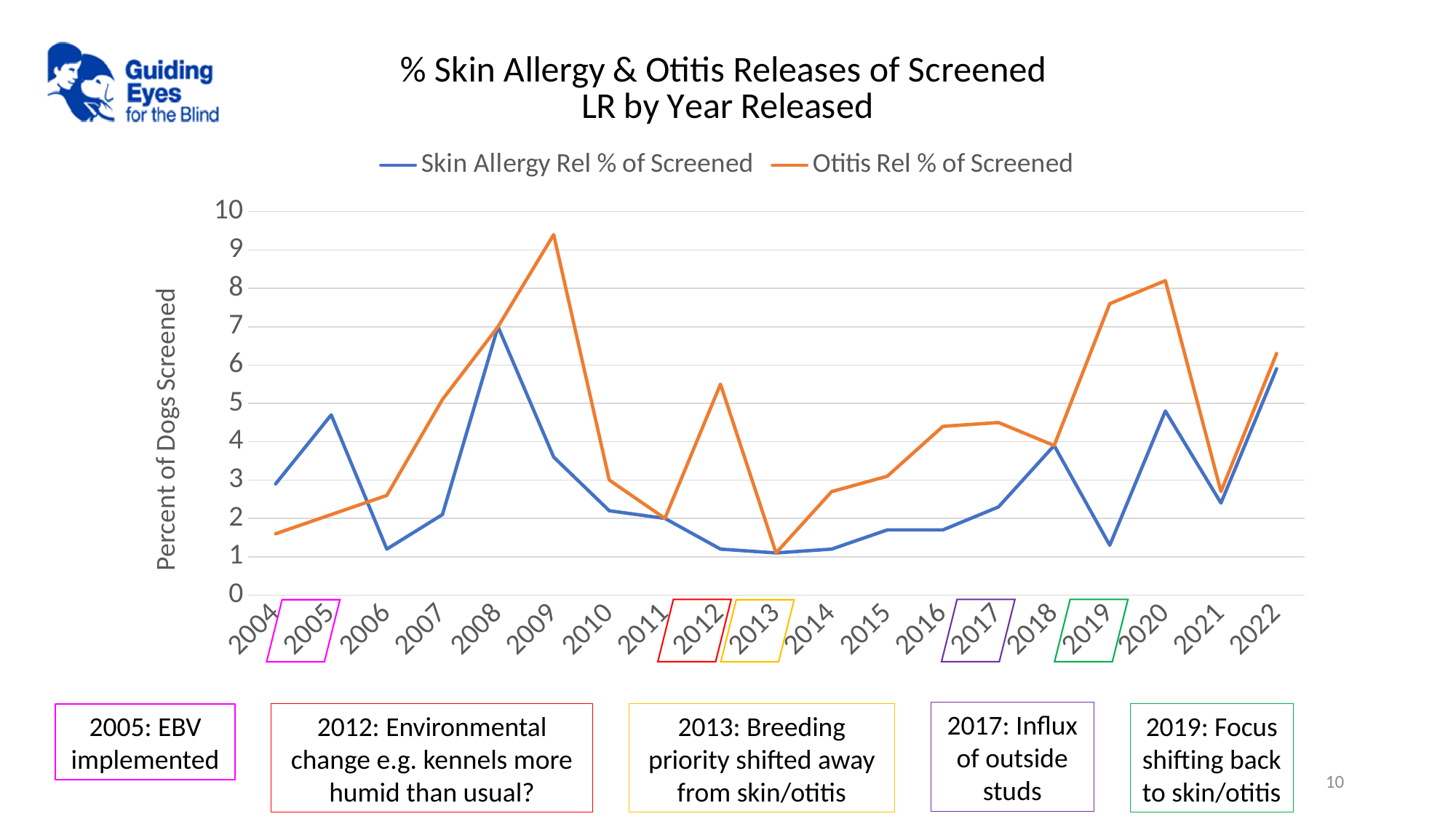
Is the Otitis Rel % of Screened value for 2020 greater or less than 7? greater Is the Skin Allergy Rel % of Screened value for 2019 greater or less than 2? less In which year does the Skin Allergy Rel % of Screened series reach its highest value? 2008 What is the title of the y axis? Percent of Dogs Screened In which year is the Otitis Rel % of Screened series at its lowest? 2013 In which year does the Otitis Rel % of Screened series reach its highest value? 2009 In 2019, which series has the larger value, Skin Allergy Rel % of Screened or Otitis Rel % of Screened? Otitis Rel % of Screened What kind of chart is shown on the slide? line chart Is the Otitis Rel % of Screened value for 2009 greater or less than 9? greater How many series does the legend list? 2 How many years are plotted along the x axis? 19 Does the Skin Allergy Rel % of Screened series rise or fall from 2009 to 2013? fall